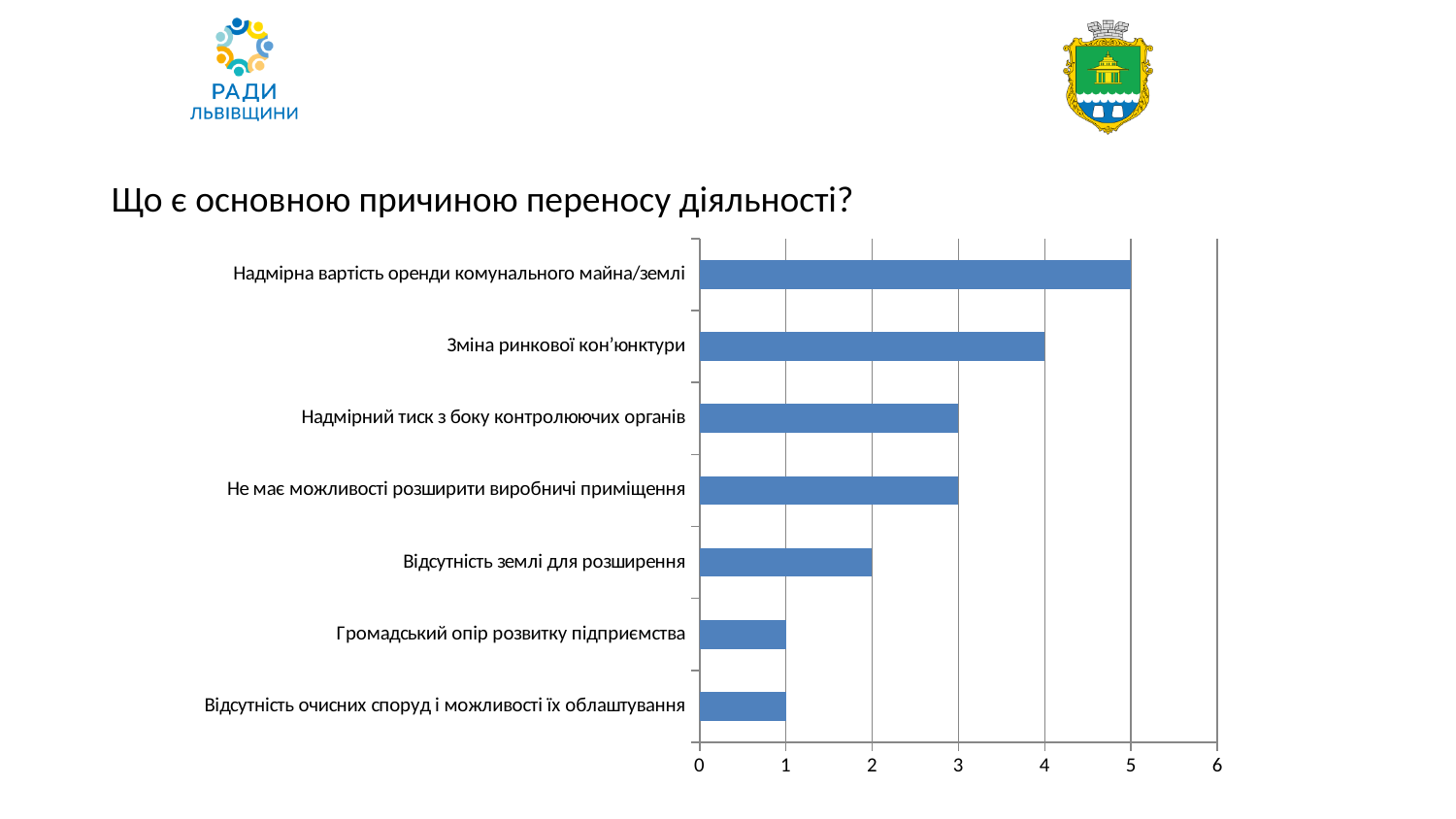
What is the value for "Зміна ринкової кон’юнктури"? 4 What is the title of the chart? Що є основною причиною переносу діяльності? What is the value for "Відсутність землі для розширення"? 2 What is the difference between the values for "Надмірна вартість оренди комунального майна/землі" and "Зміна ринкової кон’юнктури"? 1 Is the value for "Зміна ринкової кон’юнктури" greater or less than 3? greater What is the value for "Громадський опір розвитку підприємства"? 1 What is the value for "Надмірна вартість оренди комунального майна/землі"? 5 Which is larger: the value for "Надмірний тиск з боку контролюючих органів" or the value for "Відсутність землі для розширення"? Надмірний тиск з боку контролюючих органів What is the highest value shown on the x axis? 6 What type of chart is shown on the slide? bar chart How many categories are shown in the chart? 7 Which category has the highest value? Надмірна вартість оренди комунального майна/землі